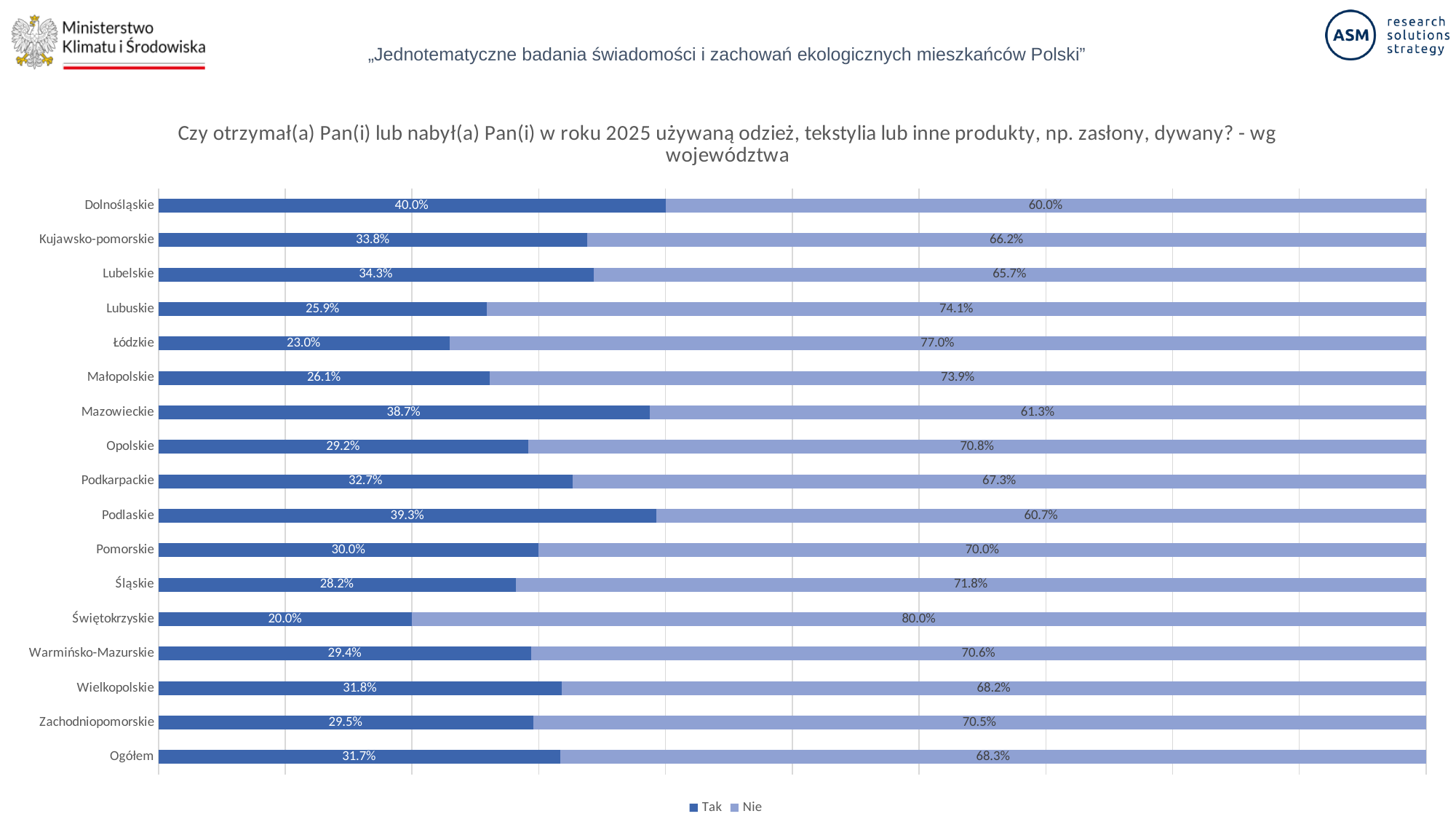
What is the difference between the 'Tak' value for Dolnośląskie and the 'Tak' value for Świętokrzyskie? 20.0 percentage points What is the 'Nie' value for Lubuskie? 74.1% How many series does the legend list? 2 Which category has the highest 'Nie' value? Świętokrzyskie What is the 'Tak' value for Mazowieckie? 38.7% Which has a larger 'Tak' value, Lubelskie or Łódzkie? Lubelskie What kind of chart is shown on the slide? Stacked bar chart Which category has the highest 'Tak' value? Dolnośląskie How many categories (rows) are plotted on the chart? 17 What are the two series named in the legend? Tak and Nie Which category has the lowest 'Tak' value? Świętokrzyskie What is the 'Tak' value for Ogółem? 31.7%